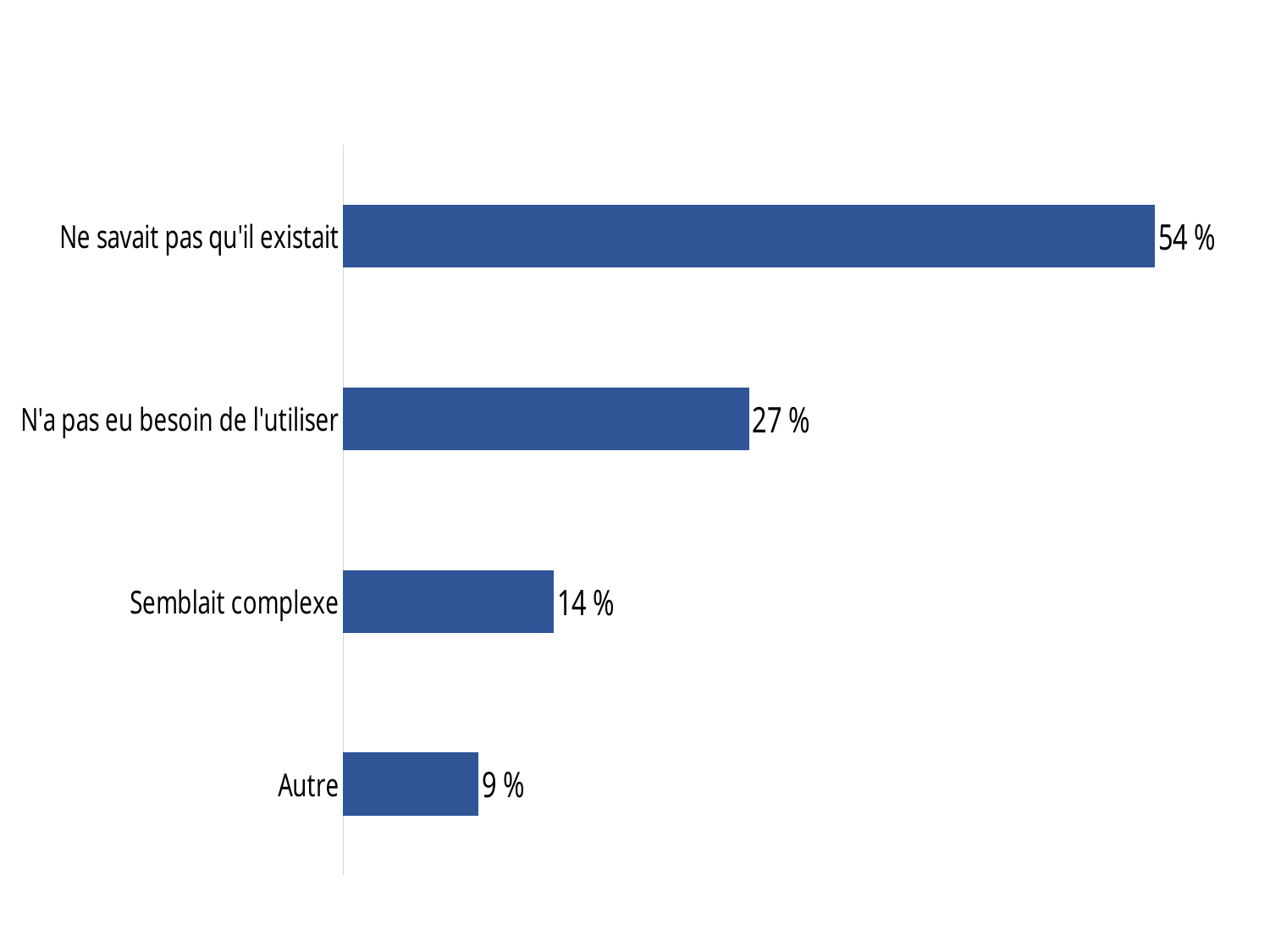
What is the value for "Autre"? 9 % What colour are the bars in the chart? Blue Which category has the lowest value? Autre What is the difference between the values for "Semblait complexe" and "Autre"? 5 % What kind of chart is shown on the slide? Bar chart Which category has the highest value? Ne savait pas qu'il existait What is the value for "N'a pas eu besoin de l'utiliser"? 27 % Which is larger, the value for "N'a pas eu besoin de l'utiliser" or the value for "Semblait complexe"? N'a pas eu besoin de l'utiliser What is the difference between the values for "Ne savait pas qu'il existait" and "N'a pas eu besoin de l'utiliser"? 27 % How many categories are shown in the chart? 4 What is the value for "Ne savait pas qu'il existait"? 54 % What is the value for "Semblait complexe"? 14 %